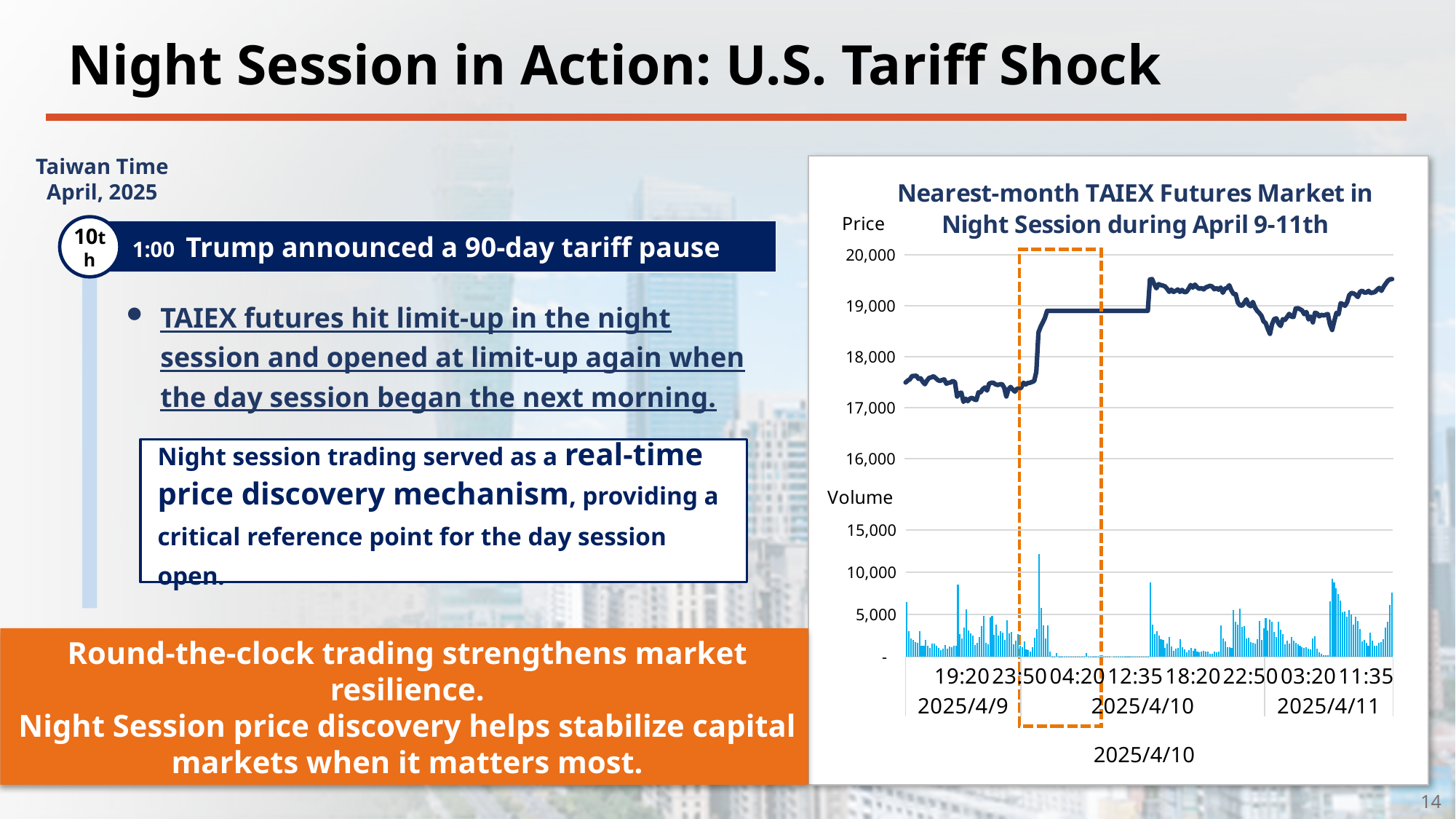
Is the price at the end of the chart on 2025/4/11 greater or less than 19,000? greater Is the price at the start of the chart on 2025/4/9 greater or less than 18,000? less How many dates are labelled along the x axis of the chart? 3 Is the price level after the sharp jump on 2025/4/10 greater or less than 18,000? greater What kind of chart is used to show the volume series in the chart? bar chart Which is higher in the chart: the price at the start of 2025/4/9 or the price at the end of 2025/4/11? the price at the end of 2025/4/11 Does the price rise or fall overall from the start of 2025/4/9 to the end of 2025/4/11? rise Which date is labelled below the dashed orange box on the chart? 2025/4/10 What kind of chart is used to show the price series in the chart? line chart What is the title of the chart on the slide? Nearest-month TAIEX Futures Market in Night Session during April 9-11th